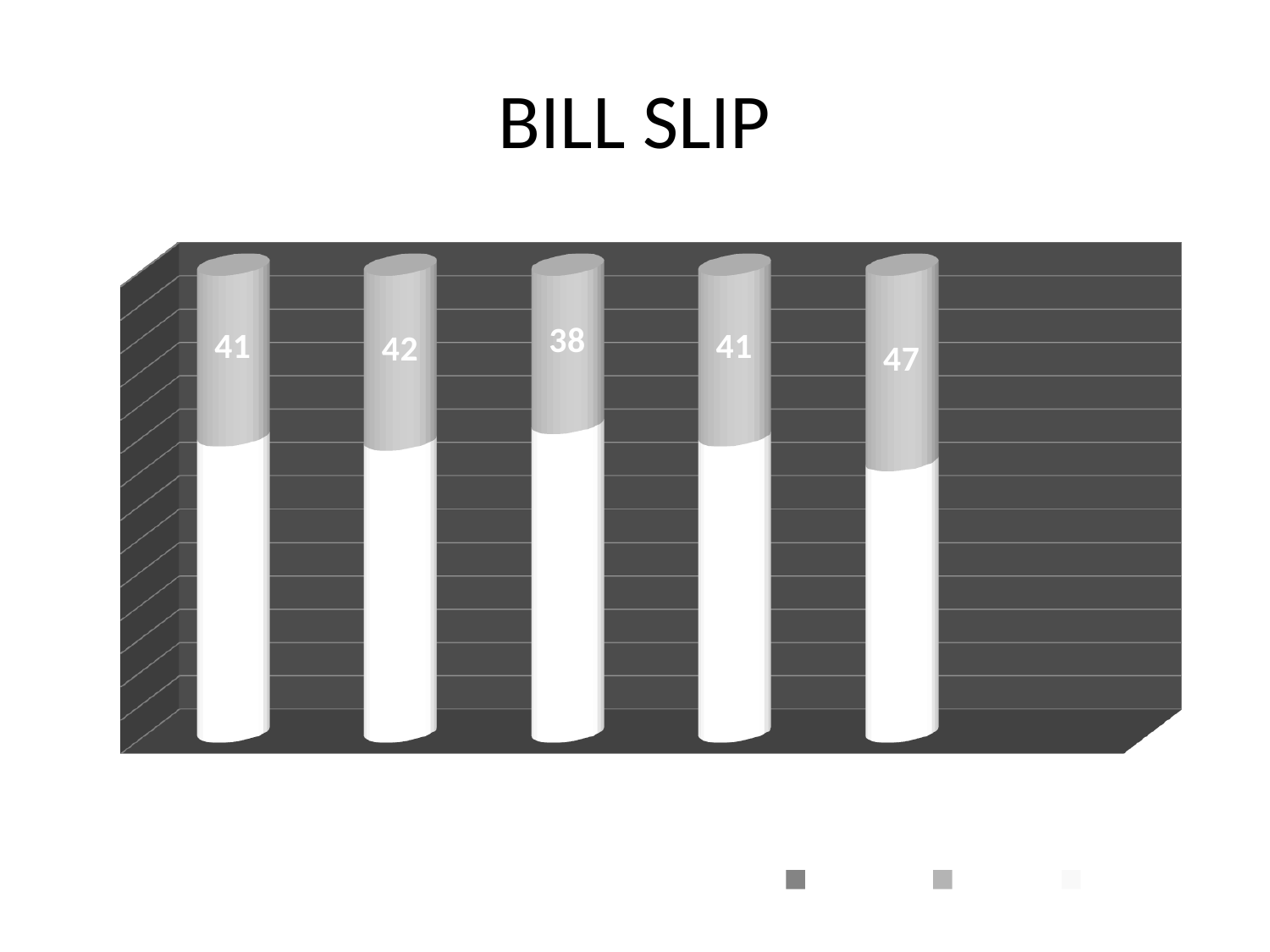
How many entries does the legend show? 3 What data label is shown on the grey segment of the second bar from the left? 42 What data label is shown on the grey segment of the first bar from the left? 41 Which bar has the highest labelled value on its grey segment? the fifth bar from the left (47) Which is larger: the labelled value on the second bar or on the third bar? the second bar (42) What is the difference between the highest labelled value (47) and the lowest labelled value (38)? 9 What data label is shown on the grey segment of the fifth bar from the left? 47 What type of chart is shown on the slide? bar chart What data label is shown on the grey segment of the third bar from the left? 38 What is the chart title? BILL SLIP How many bars are plotted in the chart? 5 Which bar has the lowest labelled value on its grey segment? the third bar from the left (38)